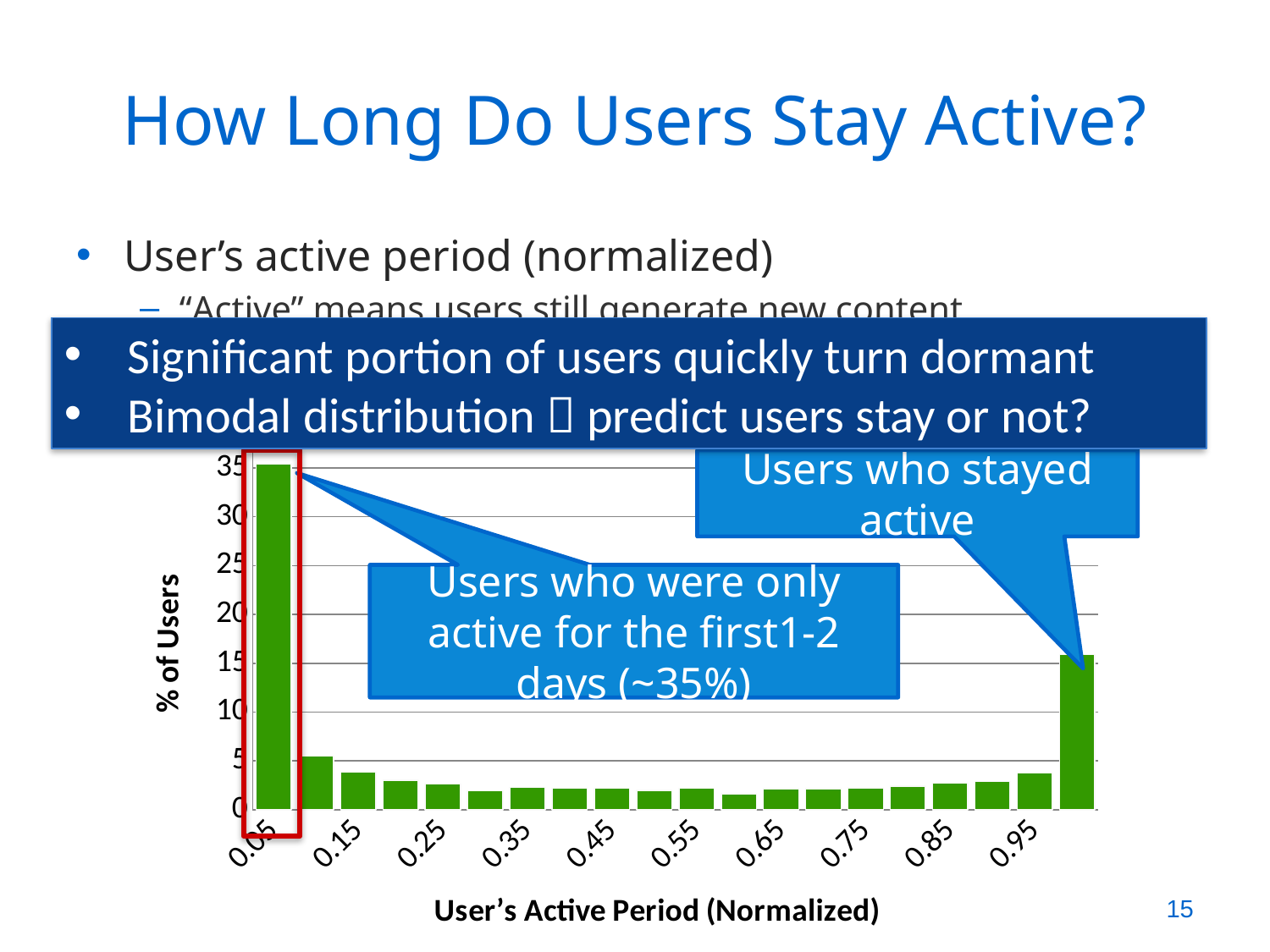
Which active period has the highest % of users? 0.05 Is the % of users for the rightmost bar greater or less than 20? less What is the title of the x axis? User's Active Period (Normalized) Which bar is taller: the one at 0.05 or the rightmost bar? 0.05 What kind of chart is shown on the slide? bar chart What is the title of the y axis? % of Users Do the bar heights rise or fall from 0.15 to 0.55 along the x axis? fall Is the % of users for the 0.05 active period greater or less than 30? greater Is the % of users for the rightmost bar greater or less than 10? greater How many tick labels are shown on the x axis? 10 Which bar is taller: the one at 0.15 or the one at 0.55? 0.15